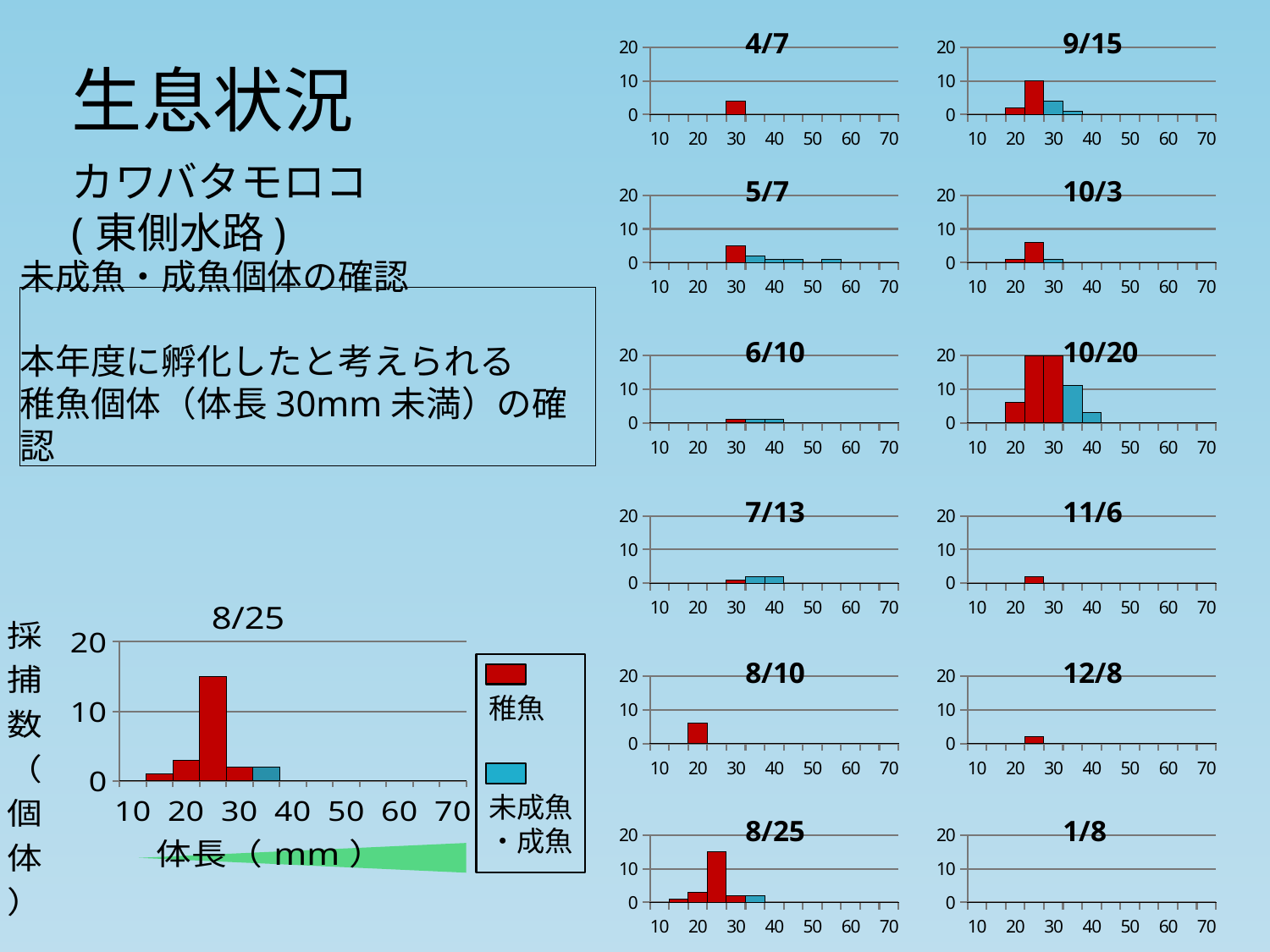
How many small dated charts are shown on the right side of the slide? 12 What is the x-axis label of the large 8/25 chart? 体長（mm） In the 8/10 chart, is the value of the red bar greater or less than 10? less How many series does the legend next to the large 8/25 chart list? 2 What kind of chart is the large 8/25 chart on the left of the slide? bar chart In the large 8/25 chart, which legend entry is shown in red? 稚魚 In the 4/7 chart, is the value of the red bar greater or less than 10? less In the large 8/25 chart, which is taller: the red bar at 20–30 mm or the blue bar at 30–40 mm? the red bar at 20–30 mm In the 10/20 chart, is the tallest red bar greater or less than 10? greater In the large 8/25 chart, which body-length range has the highest count? 20–30 mm